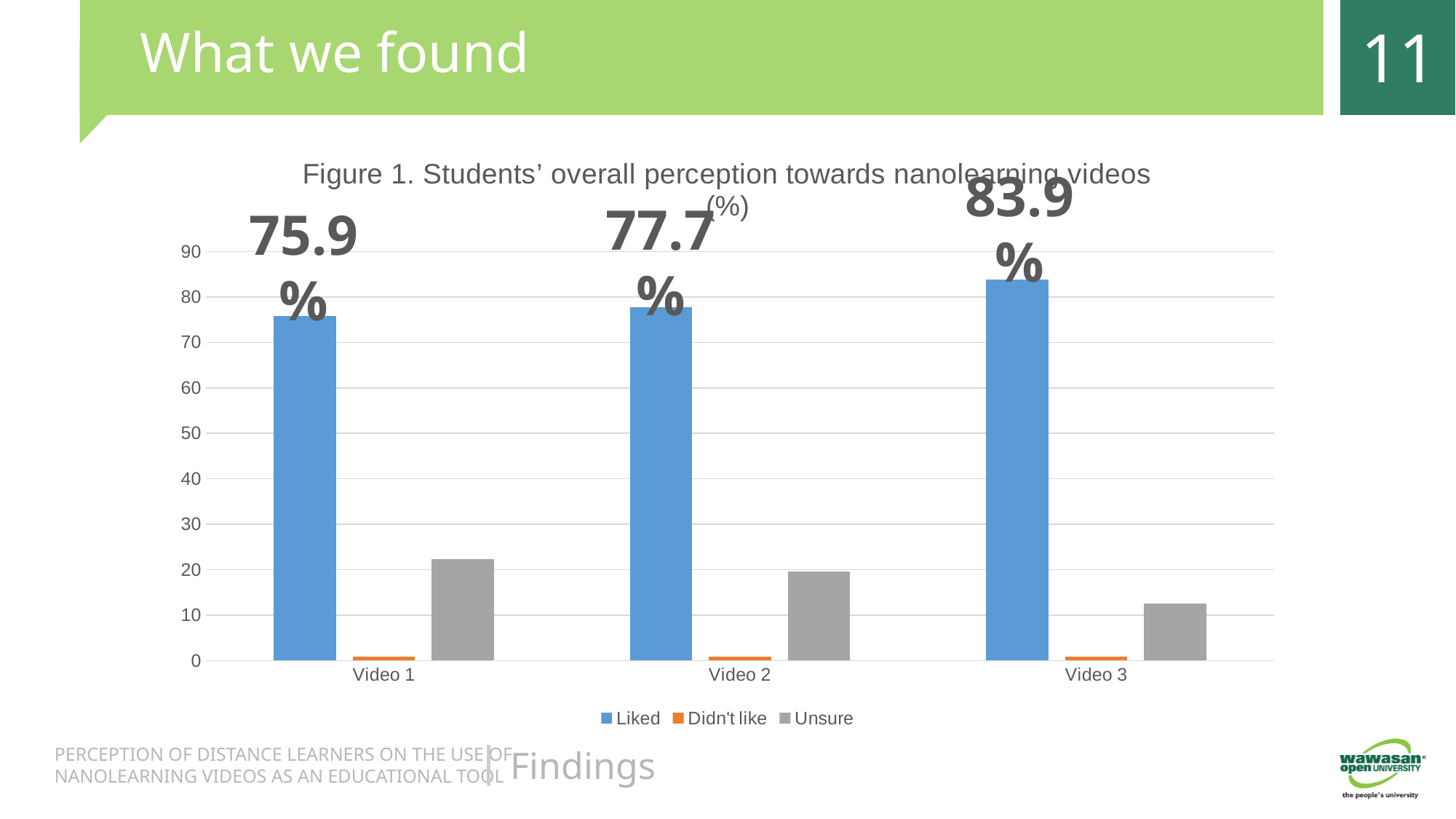
What is the difference between the Liked values for Video 3 and Video 1? 8.0% What is the value for Liked for Video 1? 75.9% Which video has the highest Liked value? Video 3 Which video has the lowest Liked value? Video 1 What is the value for Liked for Video 2? 77.7% Is the Liked value larger for Video 2 or Video 3? Video 3 Is the Unsure value for Video 1 greater or less than 20? greater What is the value for Liked for Video 3? 83.9% What kind of chart is shown on the slide? Bar chart How many series does the legend list? 3 How many videos are shown on the x axis? 3 Is the Unsure value for Video 3 greater or less than 20? less